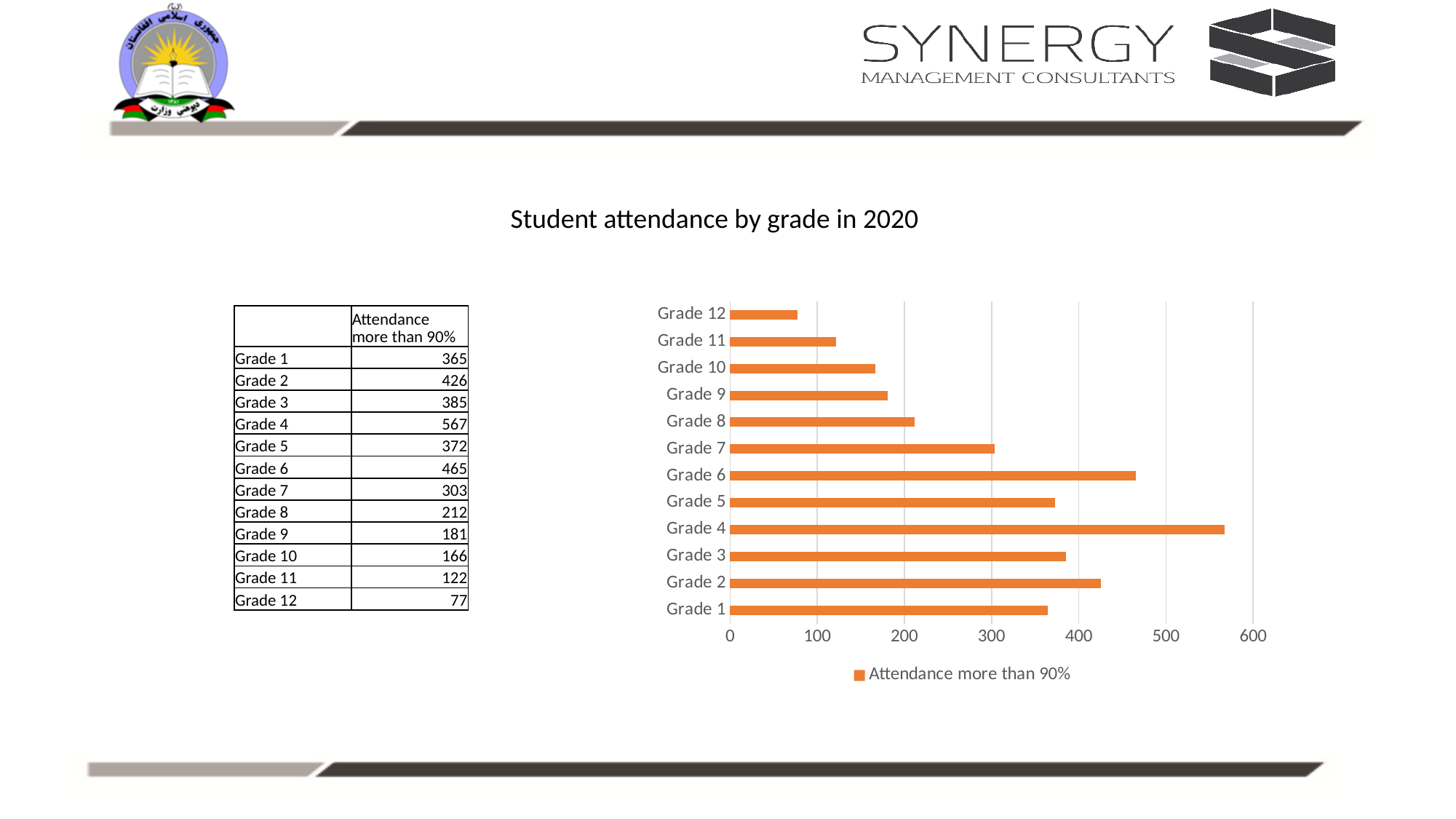
Which grade has the lowest attendance more than 90%? Grade 12 What is the attendance more than 90% value for Grade 4? 567 What is the attendance more than 90% value for Grade 12? 77 Is the value for Grade 7 greater or less than 400? less Which is larger, the value for Grade 6 or the value for Grade 2? Grade 6 What is the legend entry for the series in the chart? Attendance more than 90% What is the difference between the values for Grade 4 and Grade 12? 490 How many series does the chart legend list? 1 Do the values generally rise or fall from Grade 7 to Grade 12? fall How many grades are plotted in the chart? 12 Which grade has the highest attendance more than 90%? Grade 4 What kind of chart is shown on the slide? bar chart